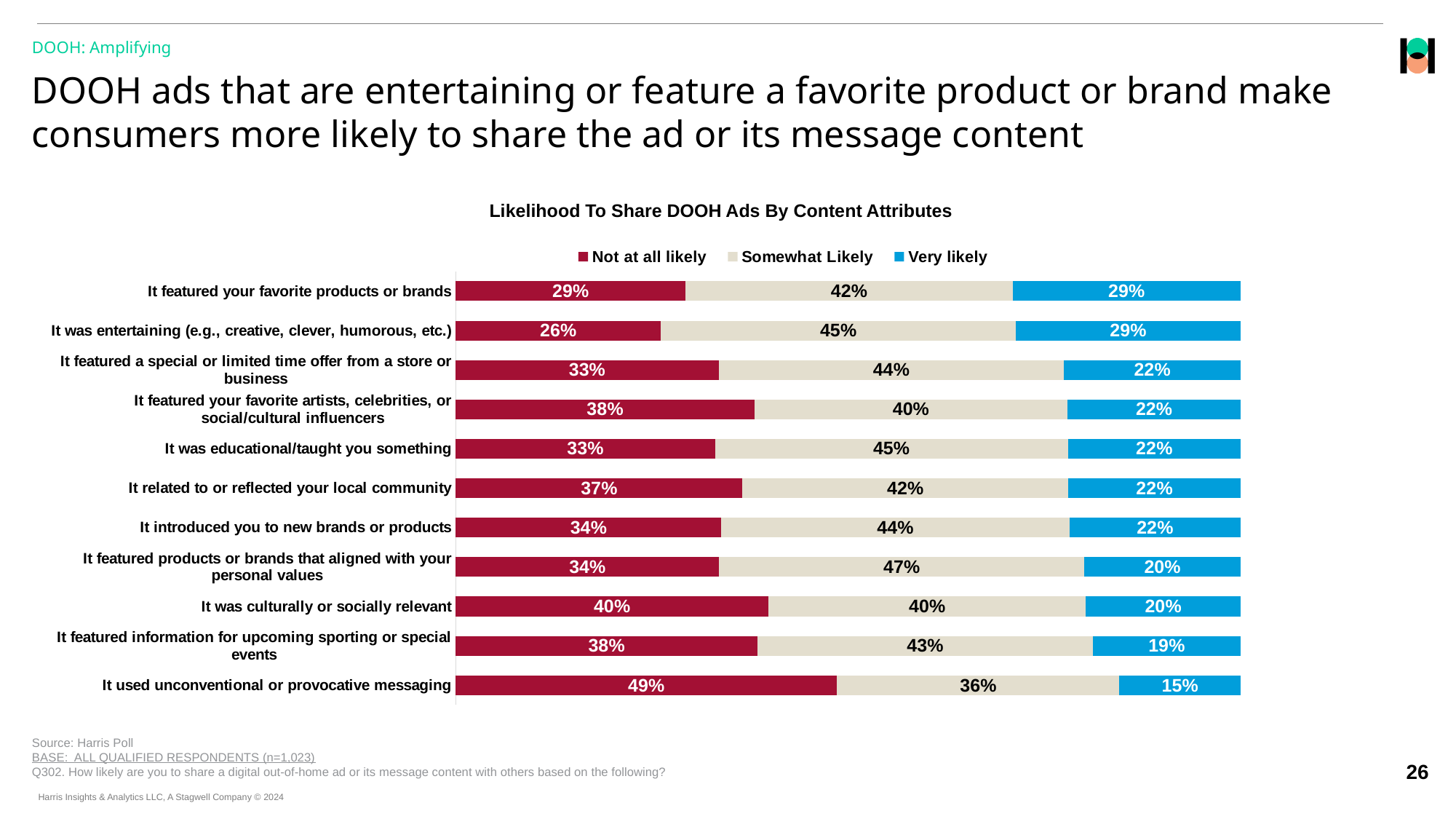
Which content attribute has the lowest "Very likely" percentage? It used unconventional or provocative messaging What is the difference between the "Not at all likely" values for "It was culturally or socially relevant" and "It was entertaining (e.g., creative, clever, humorous, etc.)"? 14% Which content attribute has the highest "Not at all likely" percentage? It used unconventional or provocative messaging How many content attributes are shown in the chart? 11 What is the total of the stacked bar for "It was educational/taught you something"? 100% What type of chart is shown on the slide? Stacked bar chart What percentage of respondents said they were "Very likely" to share a DOOH ad because it featured their favorite products or brands? 29% What is the "Not at all likely" value for "It used unconventional or provocative messaging"? 49% What is the "Somewhat Likely" value for "It featured products or brands that aligned with your personal values"? 47% How many series does the legend list? 3 Which has a larger "Very likely" share: "It was entertaining" or "It featured information for upcoming sporting or special events"? It was entertaining What is the title of the chart? Likelihood To Share DOOH Ads By Content Attributes